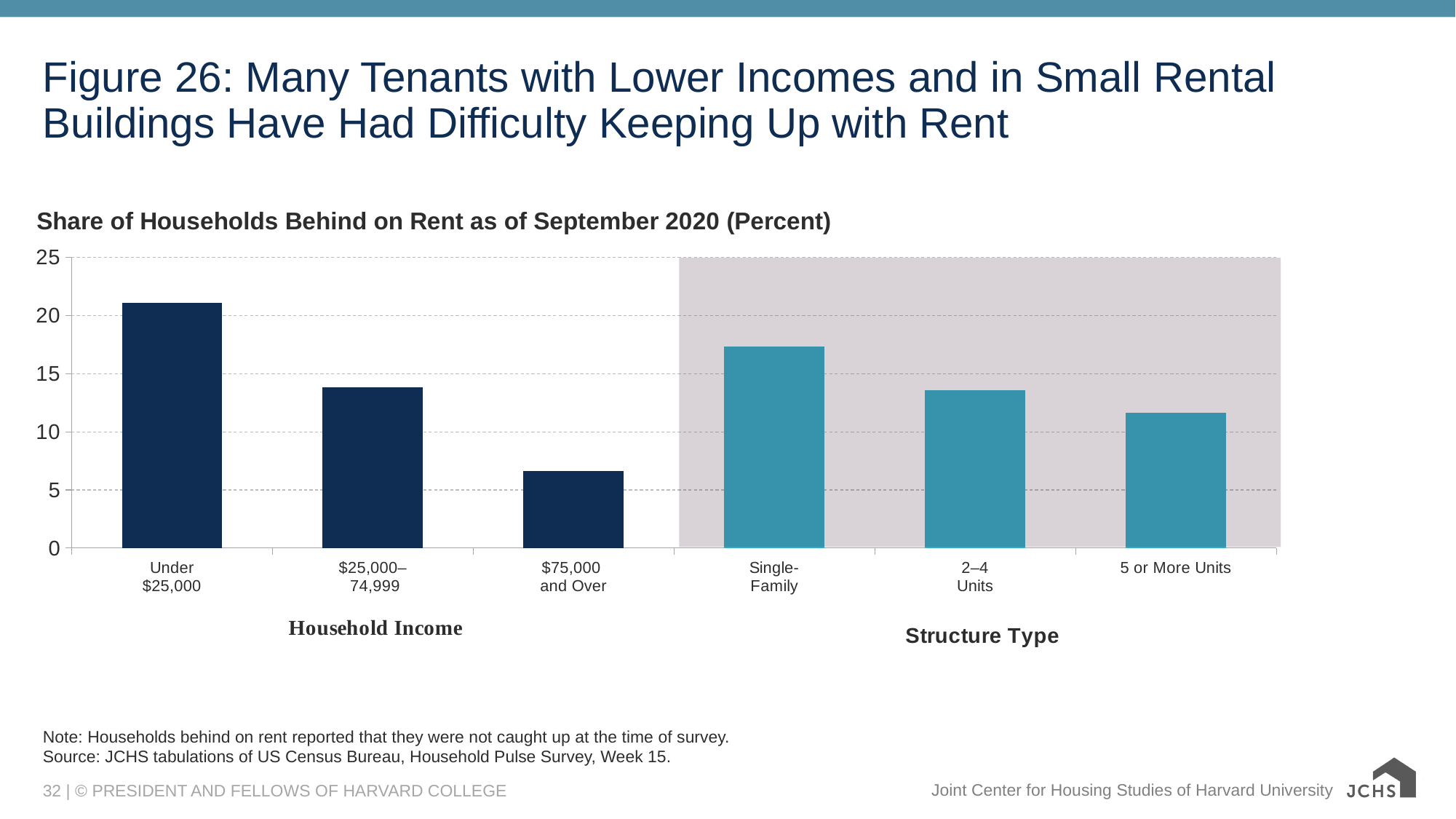
Which category has the lowest share of households behind on rent? $75,000 and Over Do the values rise or fall across the Household Income categories from Under $25,000 to $75,000 and Over? fall Which is larger, the value for Under $25,000 or the value for Single-Family? Under $25,000 Is the value for $75,000 and Over greater or less than 10? less Which category has the highest share of households behind on rent? Under $25,000 What are the two category groups labeled beneath the x axis? Household Income and Structure Type Is the value for Under $25,000 greater or less than 20? greater Is the value for Single-Family greater or less than 15? greater What kind of chart is shown on the slide? Bar chart How many bars are plotted in the chart? 6